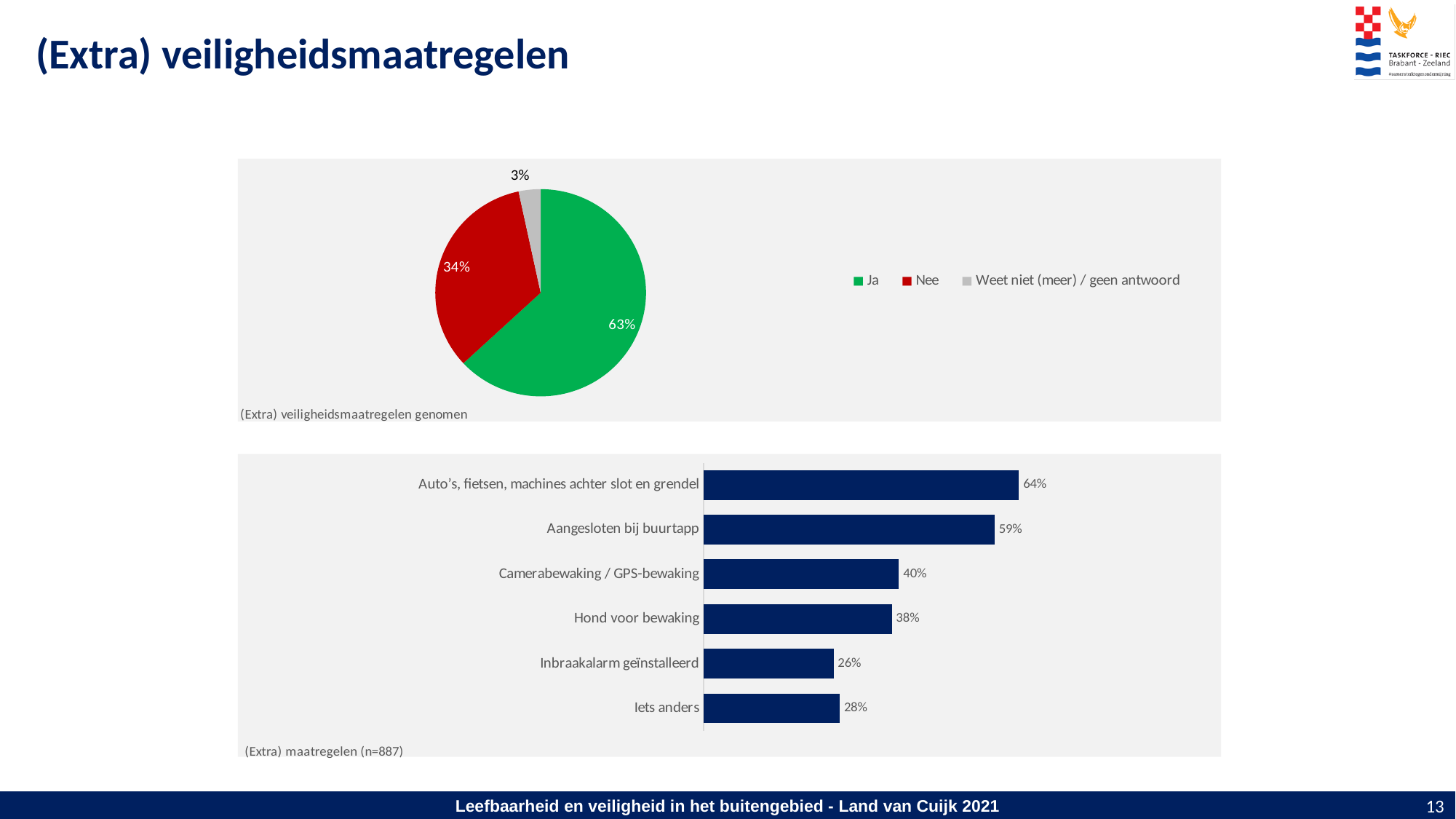
In the bar chart '(Extra) maatregelen (n=887)', which category has the lowest value? Inbraakalarm geïnstalleerd In the pie chart '(Extra) veiligheidsmaatregelen genomen', how many slices does the legend list? 3 In the bar chart '(Extra) maatregelen (n=887)', which is larger: 'Iets anders' or 'Inbraakalarm geïnstalleerd'? Iets anders In the pie chart '(Extra) veiligheidsmaatregelen genomen', which slice is the largest? Ja In the bar chart '(Extra) maatregelen (n=887)', what is the difference between 'Camerabewaking / GPS-bewaking' and 'Inbraakalarm geïnstalleerd'? 14% In the bar chart '(Extra) maatregelen (n=887)', what is the value for 'Aangesloten bij buurtapp'? 59% In the bar chart '(Extra) maatregelen (n=887)', what is the value for 'Hond voor bewaking'? 38% In the pie chart '(Extra) veiligheidsmaatregelen genomen', what share is 'Ja'? 63% In the bar chart '(Extra) maatregelen (n=887)', which category has the highest value? Auto’s, fietsen, machines achter slot en grendel In the pie chart '(Extra) veiligheidsmaatregelen genomen', what share is 'Nee'? 34% In the bar chart '(Extra) maatregelen (n=887)', how many categories are shown? 6 In the pie chart '(Extra) veiligheidsmaatregelen genomen', what share is 'Weet niet (meer) / geen antwoord'? 3%